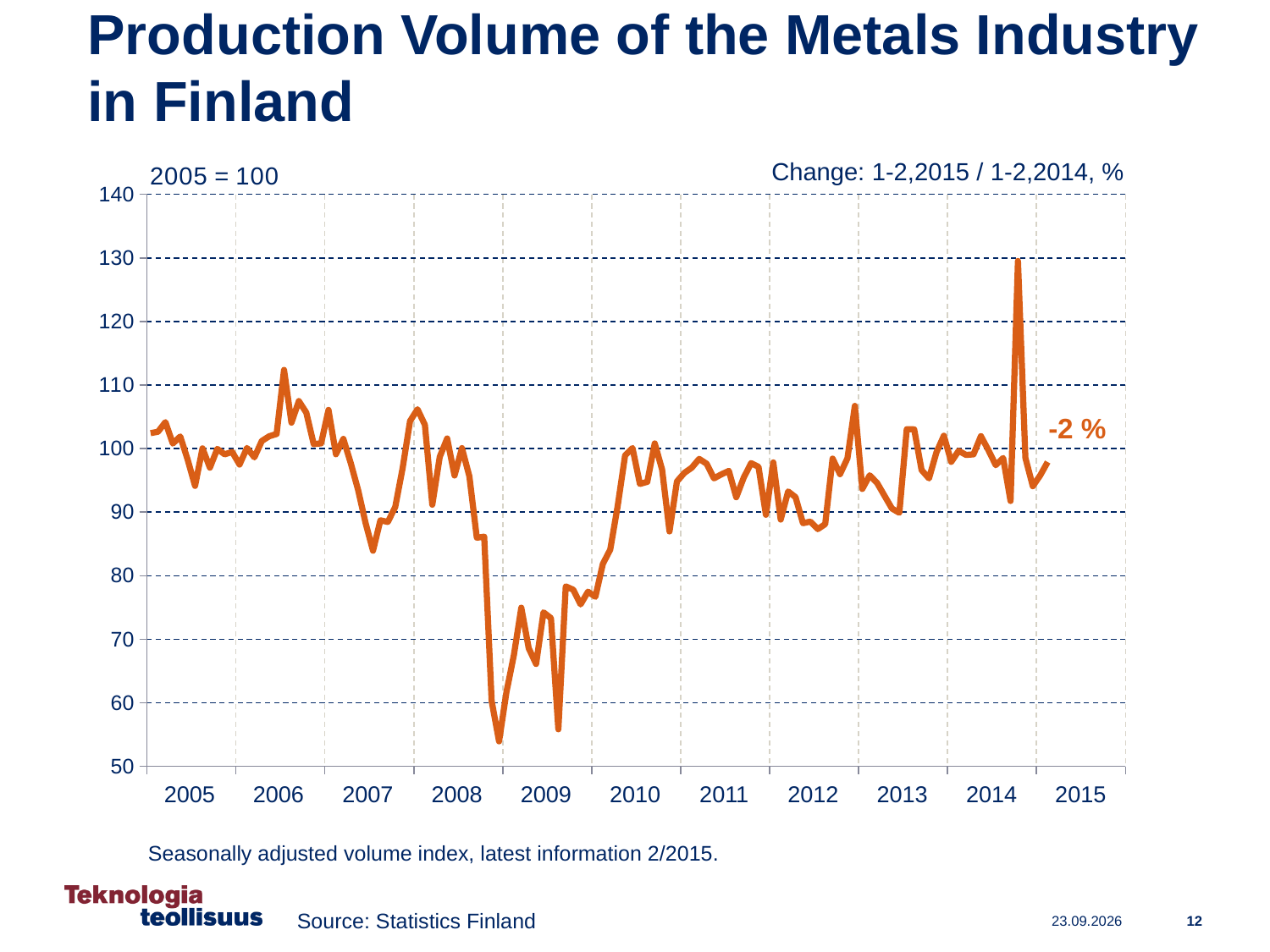
Does the line rise or fall between 2009 and 2010? rise Is the value at the start of 2005 greater or less than 90? greater Does the line rise or fall between 2008 and early 2009? fall Is the value at the end of the line in 2015 greater or less than 80? greater What base year and value is the index set to, as shown above the chart? 2005 = 100 What is the title of the chart on the slide? Production Volume of the Metals Industry in Finland In which year does the line reach its highest value? 2014 What kind of chart is shown on the slide? line chart Is the highest peak of the line, in 2014, greater or less than 120? greater What is the change for 1-2,2015 compared with 1-2,2014 shown on the chart? -2 % How many year labels are shown on the x axis? 11